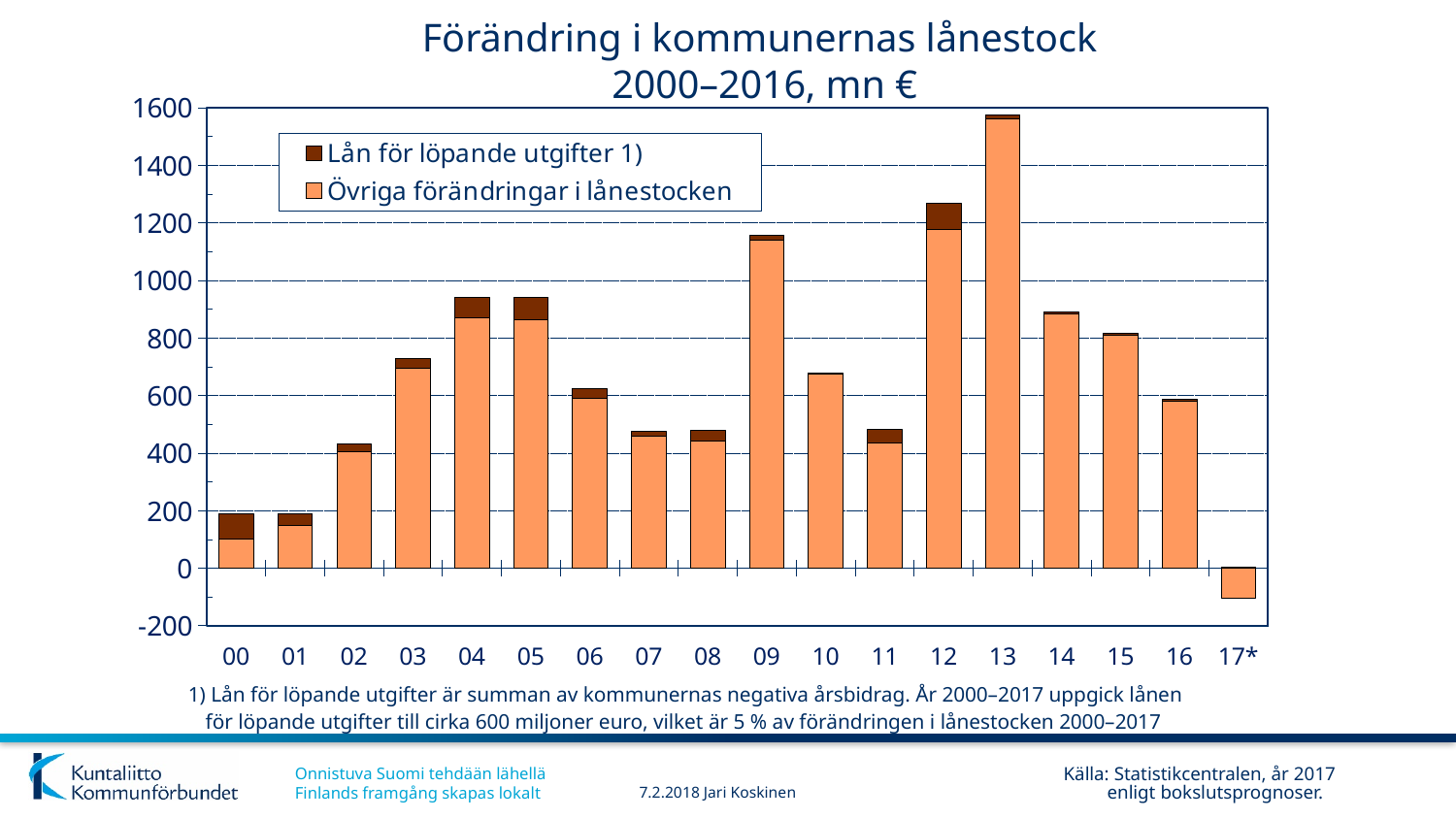
Is the value for 17* greater or less than 0? less How many series does the legend list? 2 Is the total value for 10 greater or less than 800? less Is the total value for 13 greater or less than 1400? greater Which year has the highest total change in the loan stock? 13 What kind of chart is shown on the slide? Stacked bar chart Which year has the larger total bar, 12 or 14? 12 What is the title of the chart? Förändring i kommunernas lånestock 2000–2016, mn € Which year has the lowest total change in the loan stock? 17* How many year categories are shown on the x axis? 18 Do the total values rise or fall from 13 to 17*? fall